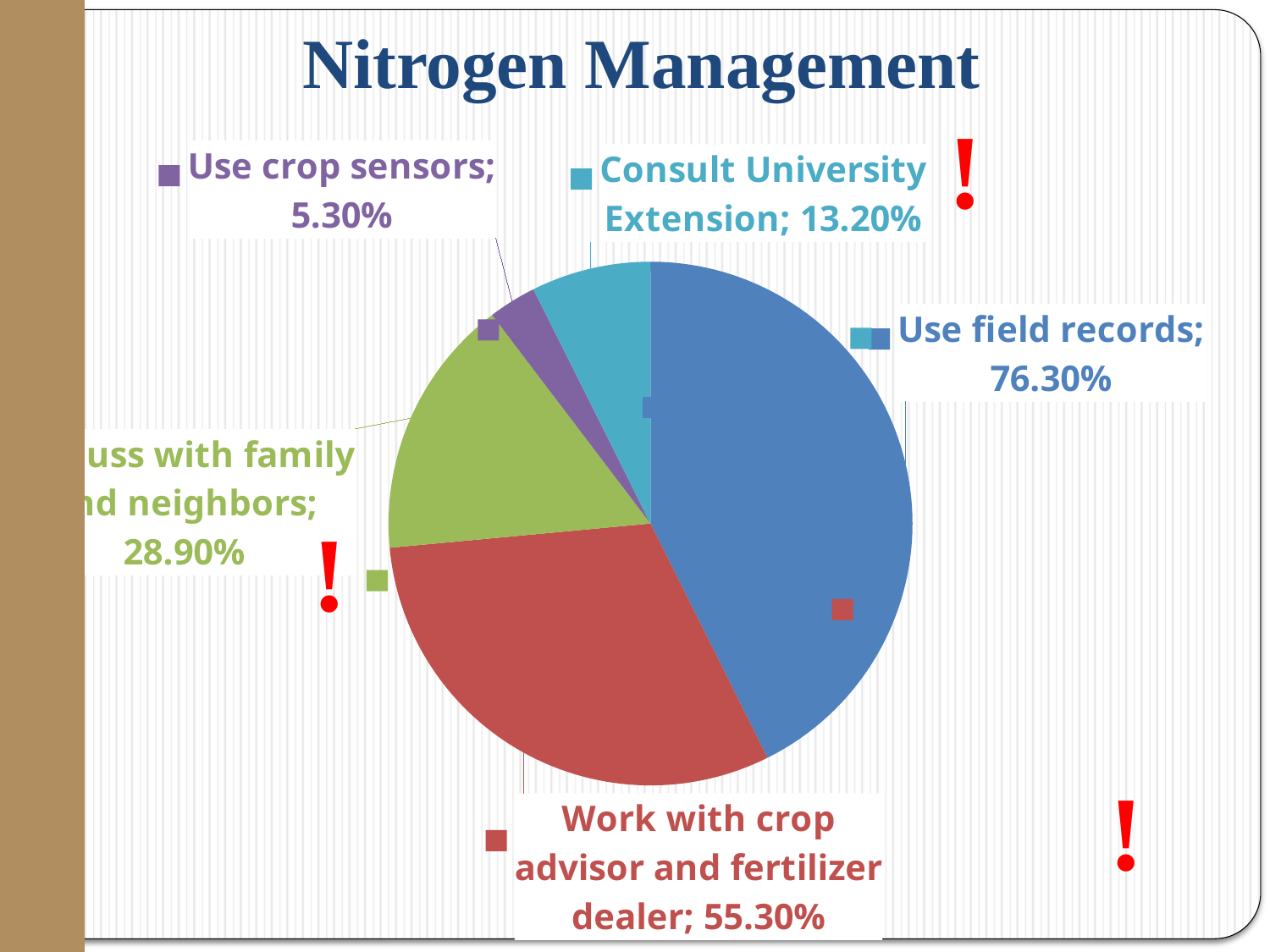
What is the value shown for Use field records? 76.30% Which category has the highest value in the pie chart? Use field records Which is larger, the value for Consult University Extension or the value for Use crop sensors? Consult University Extension What is the value shown for Consult University Extension? 13.20% How many slices does the pie chart have? 5 Which category has the lowest value in the pie chart? Use crop sensors What is the title of the chart? Nitrogen Management What is the difference between the values for Use field records and Work with crop advisor and fertilizer dealer? 21.00% What colour is the slice for Use field records? blue What kind of chart is shown on the slide? pie chart What is the value shown for Use crop sensors? 5.30% What is the value shown for Work with crop advisor and fertilizer dealer? 55.30%